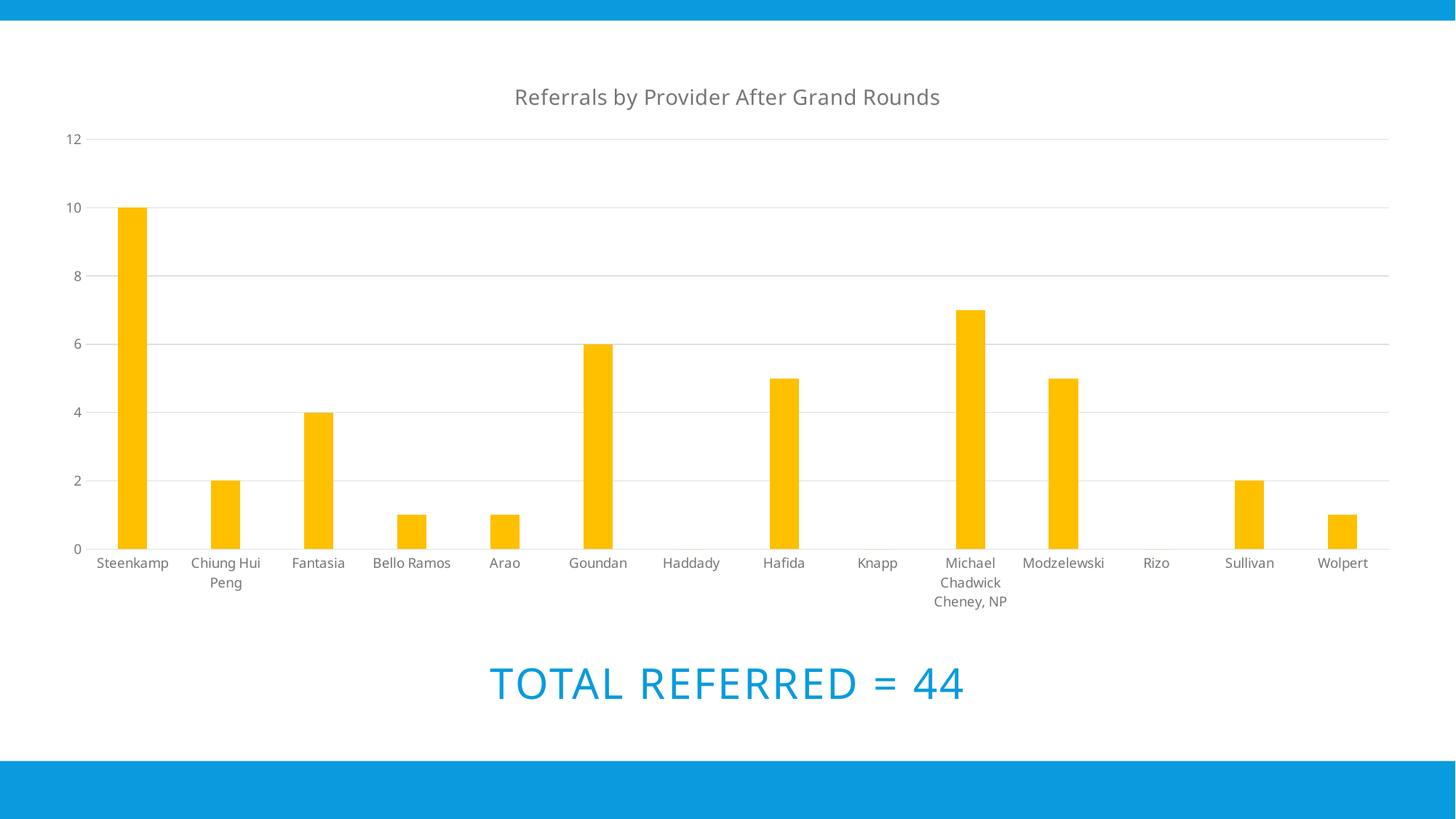
How many referrals does Sullivan have? 2 How many referrals does Steenkamp have? 10 How many referrals does Fantasia have? 4 Which provider has the highest number of referrals? Steenkamp What is the difference in referrals between Steenkamp and Goundan? 4 Who has more referrals, Goundan or Fantasia? Goundan Is the value for Michael Chadwick Cheney, NP greater or less than 6? greater How many providers are listed along the x axis of the chart? 14 What is the title of the chart? Referrals by Provider After Grand Rounds What kind of chart is shown on the slide? bar chart Is the value for Bello Ramos greater or less than 2? less How many referrals does Goundan have? 6